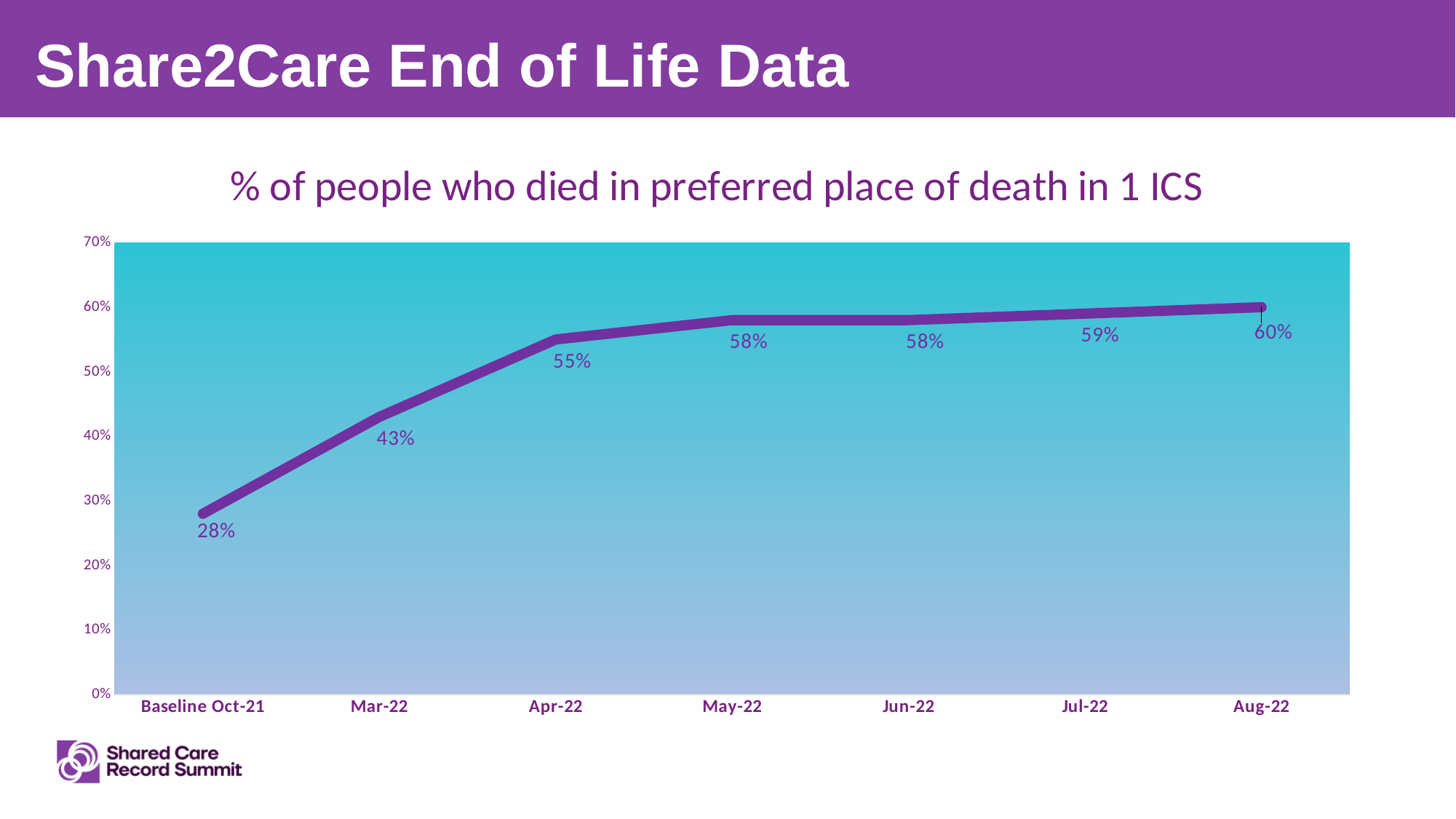
What is the value for Baseline Oct-21? 28% How many data points are plotted on the chart? 7 Do the values rise or fall from Baseline Oct-21 to Aug-22? Rise Which point on the chart has the highest value? Aug-22 What is the difference between the Aug-22 value and the Baseline Oct-21 value? 32% Which is larger, the value for Mar-22 or the value for Apr-22? Apr-22 Which point on the chart has the lowest value? Baseline Oct-21 What is the difference between the Apr-22 value and the Mar-22 value? 12% What is the value for Mar-22? 43% What is the value for Aug-22? 60% What is the value for Apr-22? 55% What kind of chart is shown on the slide? Line chart